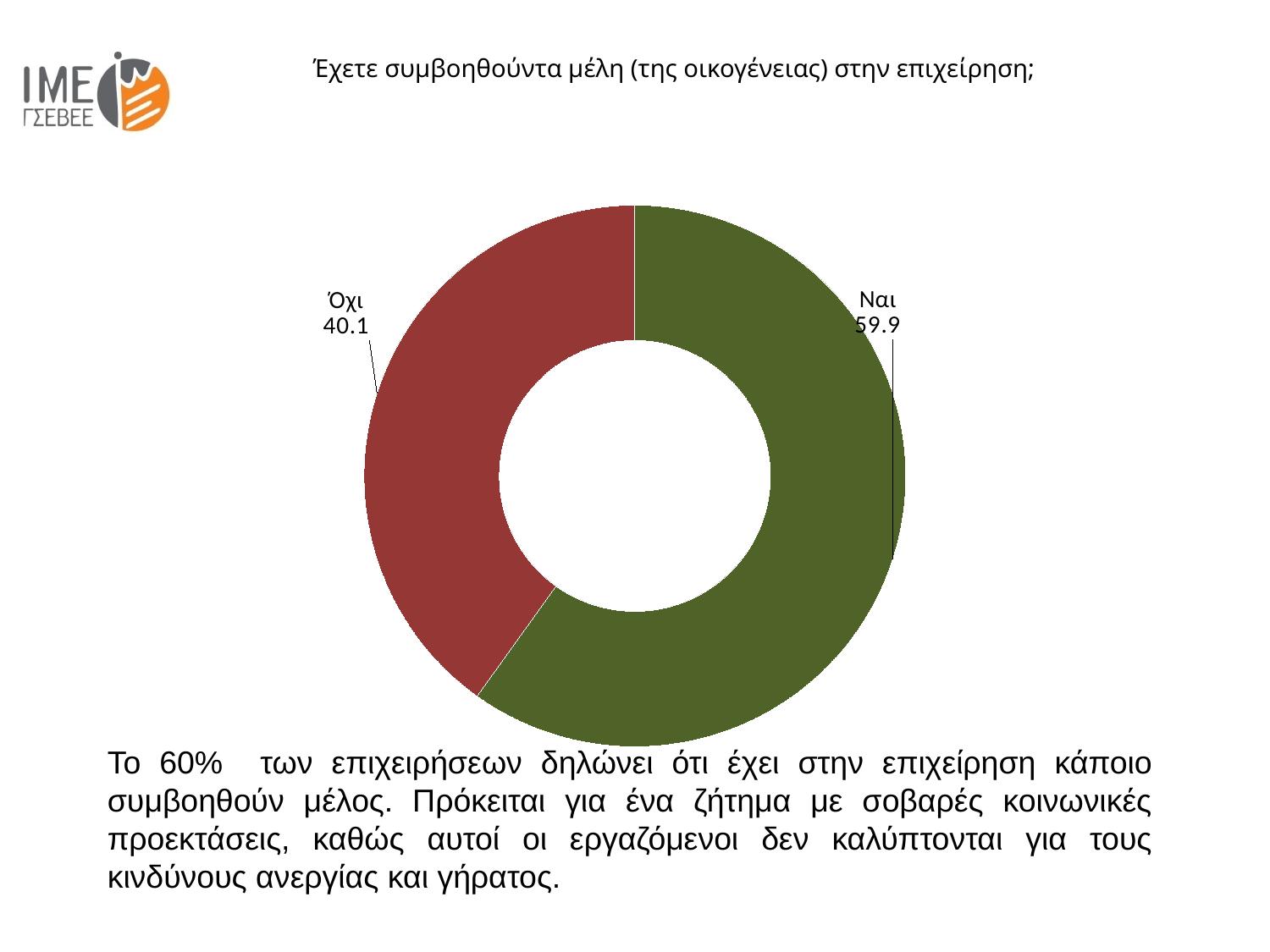
How many slices does the chart have? 2 What is the difference between the 'Ναι' and 'Όχι' values? 19.8 Which is larger, the 'Ναι' slice or the 'Όχι' slice? Ναι Which category has the largest slice? Ναι What value is shown for the 'Ναι' slice? 59.9 What is the title of the chart? Έχετε συμβοηθούντα μέλη (της οικογένειας) στην επιχείρηση; What kind of chart is shown on the slide? Doughnut (pie) chart Which category has the smallest slice? Όχι What colour is the 'Όχι' slice? Red What is the total of the two slice values? 100 What value is shown for the 'Όχι' slice? 40.1